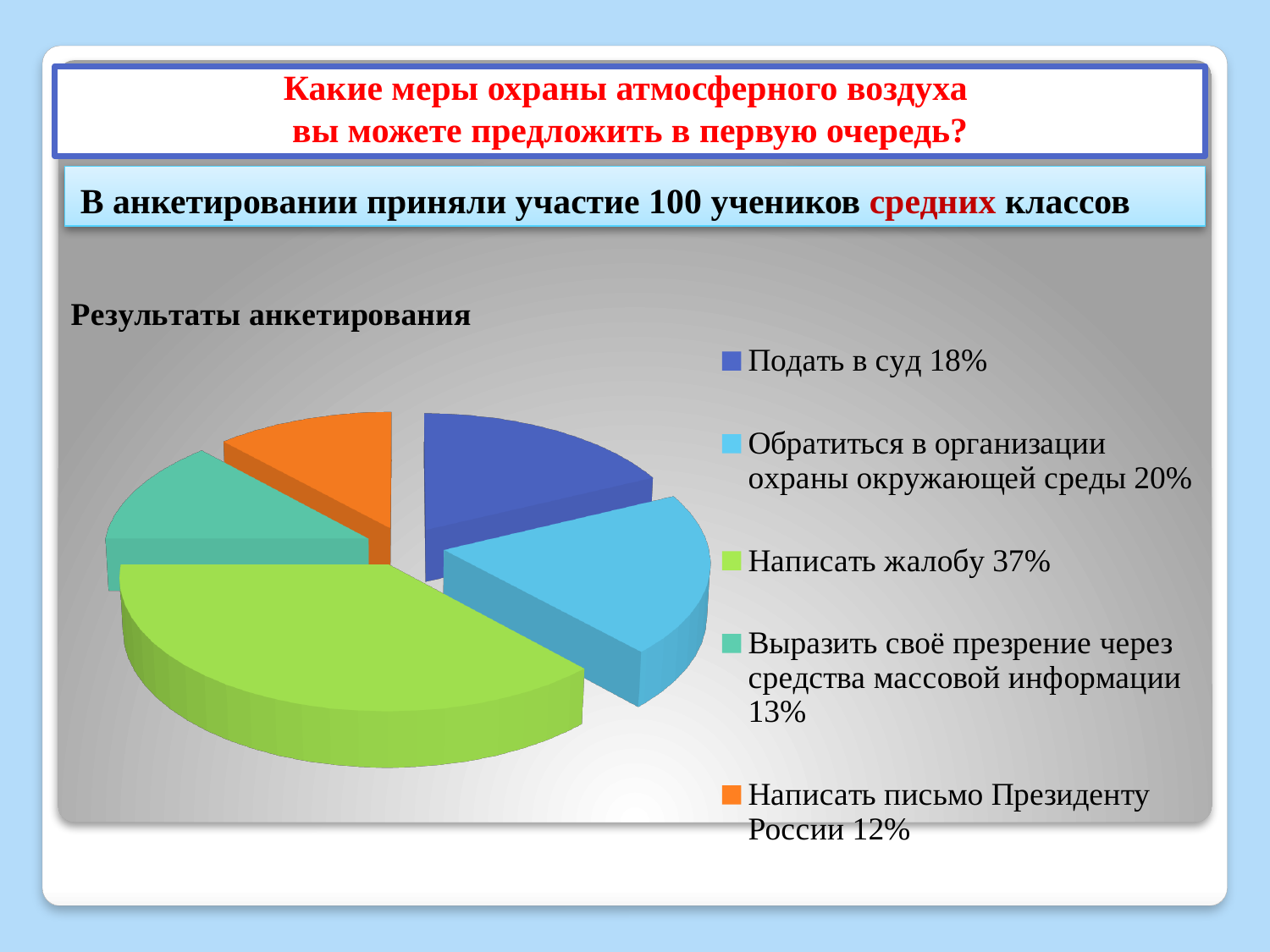
How many categories does the pie chart have? 5 What is the difference between the shares for "Написать жалобу" and "Обратиться в организации охраны окружающей среды"? 17% Which category has the smallest share of the pie? Написать письмо Президенту России What percentage is shown for "Написать жалобу"? 37% What kind of chart is shown on the slide? Pie chart What colour is the slice for "Написать жалобу"? Green What percentage is shown for "Написать письмо Президенту России"? 12% What is the title of the chart? Результаты анкетирования What percentage is shown for "Выразить своё презрение через средства массовой информации"? 13% Which category has the largest share of the pie? Написать жалобу Which is larger: the share for "Подать в суд" or the share for "Обратиться в организации охраны окружающей среды"? Обратиться в организации охраны окружающей среды What percentage is shown for "Подать в суд"? 18%